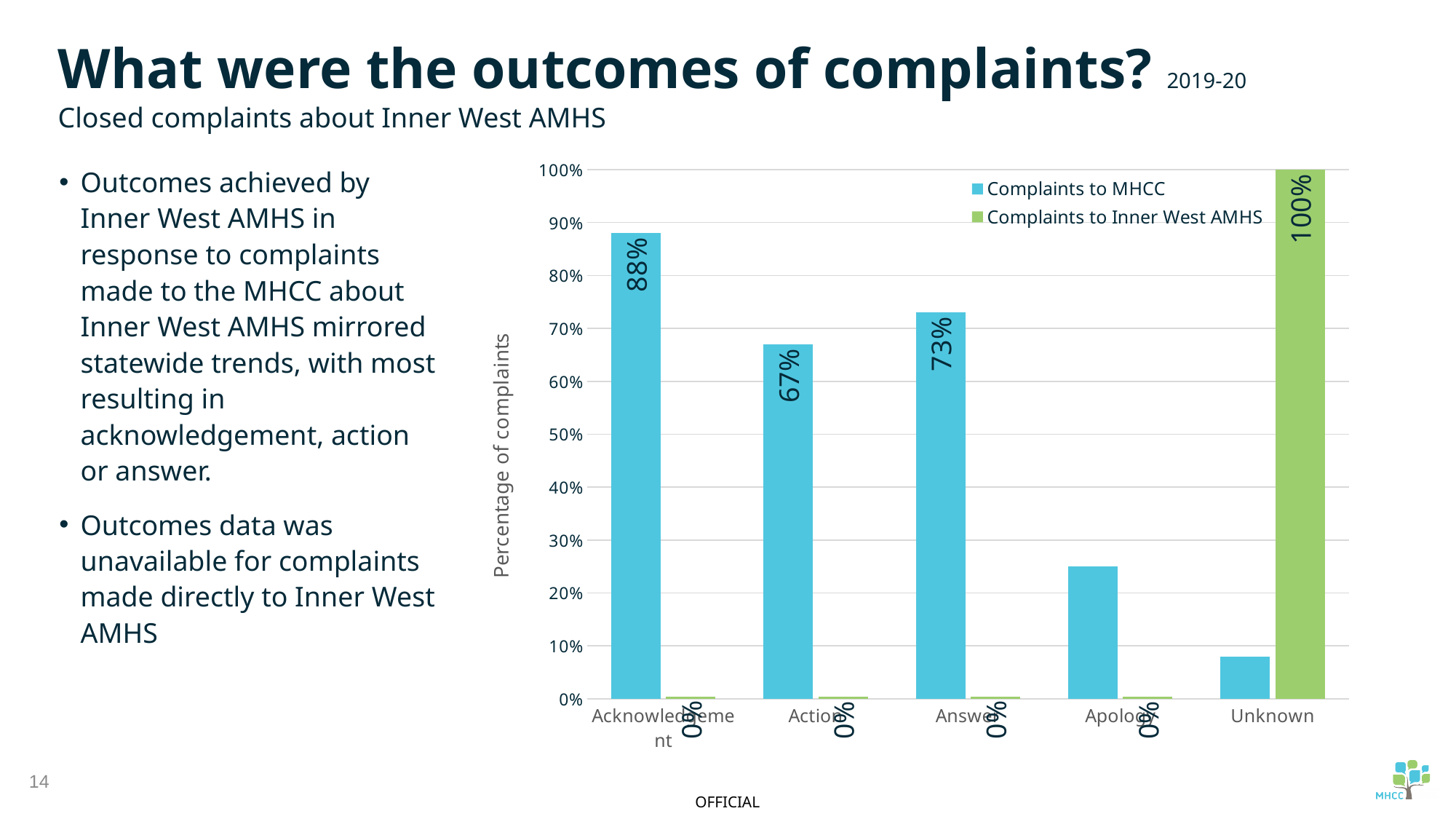
Which is larger in the Complaints to MHCC series, Answer or Action? Answer What is the value for Action in the Complaints to MHCC series? 67% What is the difference between the Acknowledgement and Action values in the Complaints to MHCC series? 21% Is the value for Apology in the Complaints to MHCC series greater or less than 30%? less Which category has the highest value in the Complaints to MHCC series? Acknowledgement What kind of chart is shown on the slide? bar chart Which category has the lowest value in the Complaints to MHCC series? Unknown What is the value for Acknowledgement in the Complaints to MHCC series? 88% What is the value for Unknown in the Complaints to Inner West AMHS series? 100% What is the value for Apology in the Complaints to Inner West AMHS series? 0% How many outcome categories are shown on the x axis? 5 How many series does the legend list? 2